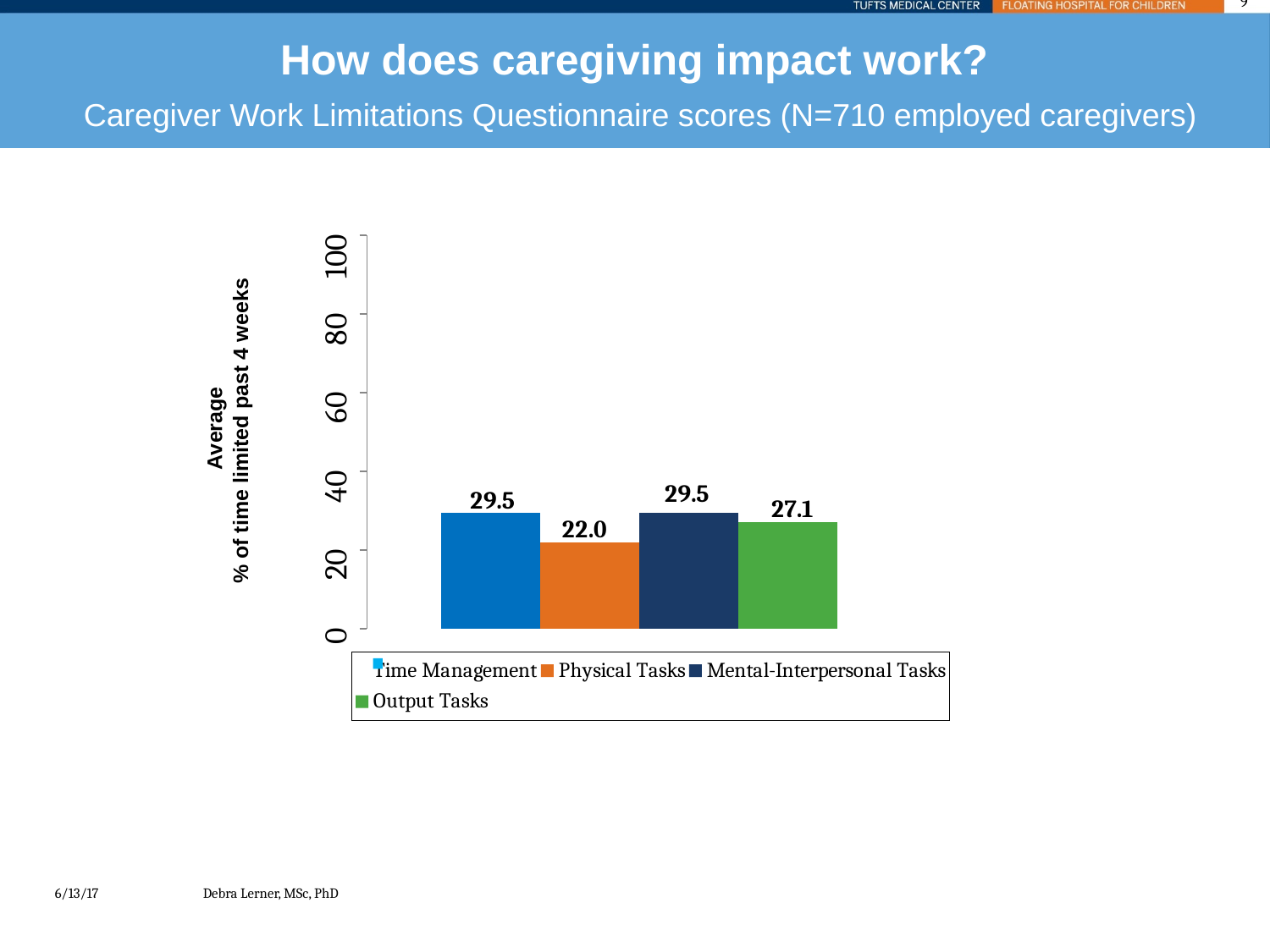
Which is larger, the value for Output Tasks or the value for Physical Tasks? Output Tasks What is the value for Mental-Interpersonal Tasks? 29.5 What is the value for Physical Tasks? 22.0 How many series does the legend list? 4 What is the value for Output Tasks? 27.1 What is the value for Time Management? 29.5 What is the difference between the values for Output Tasks and Physical Tasks? 5.1 Is the value for Mental-Interpersonal Tasks greater or less than 40? less What kind of chart is shown on the slide? bar chart Which category has the lowest value? Physical Tasks What is the difference between the values for Time Management and Physical Tasks? 7.5 What is the label of the vertical axis? Average % of time limited past 4 weeks